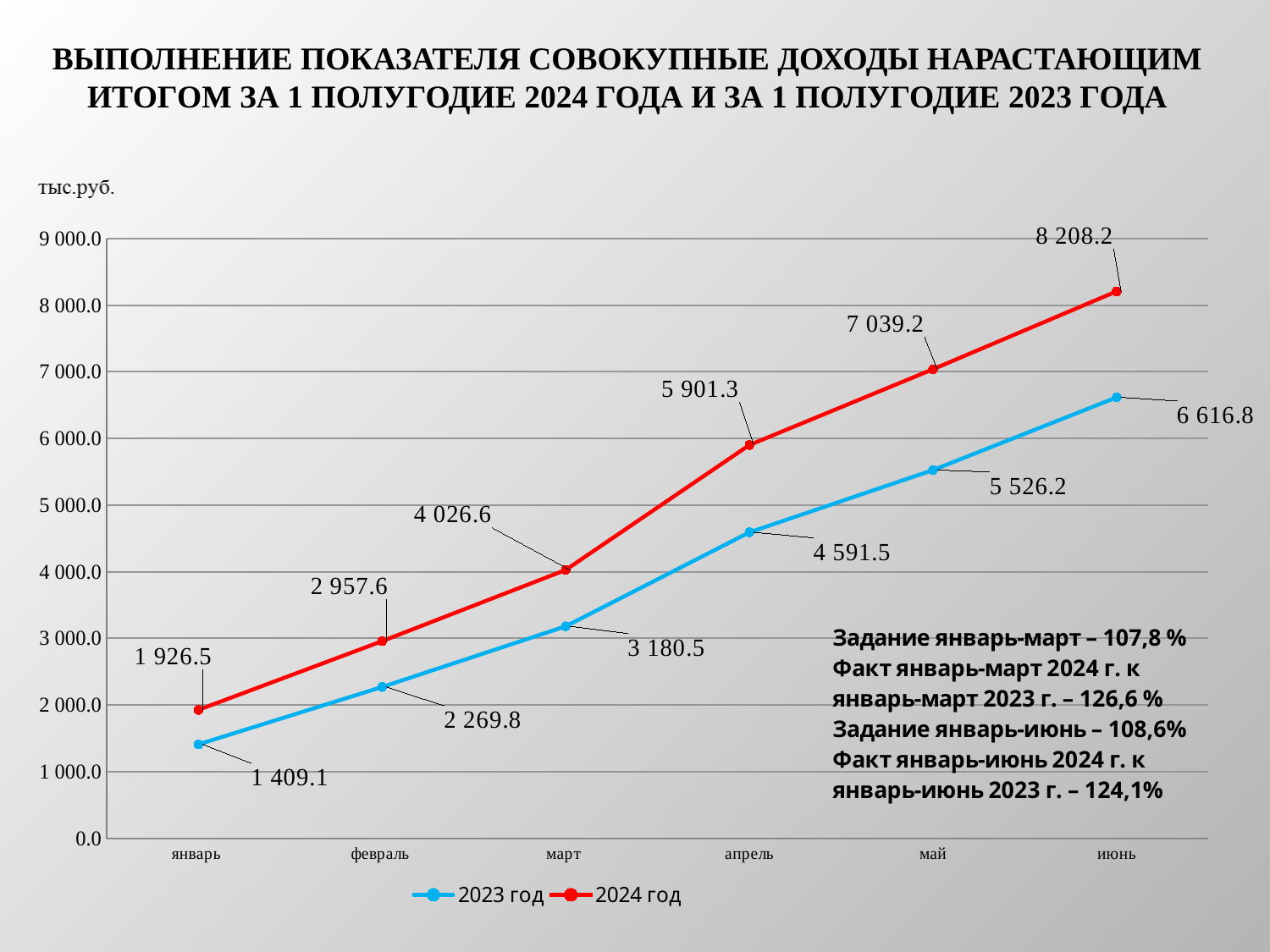
In which month is the 2024 год series lowest? январь What is the value for 2024 год in март? 4 026.6 Which series has the larger value in май, 2023 год or 2024 год? 2024 год What is the difference between the 2024 год and 2023 год values in январь? 517.4 What kind of chart is shown on the slide? line chart What is the value for 2023 год in апрель? 4 591.5 How many series does the legend list? 2 In which month does the 2023 год series reach its highest value? июнь How many months are shown on the x axis? 6 What is the difference between the 2024 год and 2023 год values in июнь? 1 591.4 What is the value for 2024 год in июнь? 8 208.2 What is the value for 2023 год in январь? 1 409.1